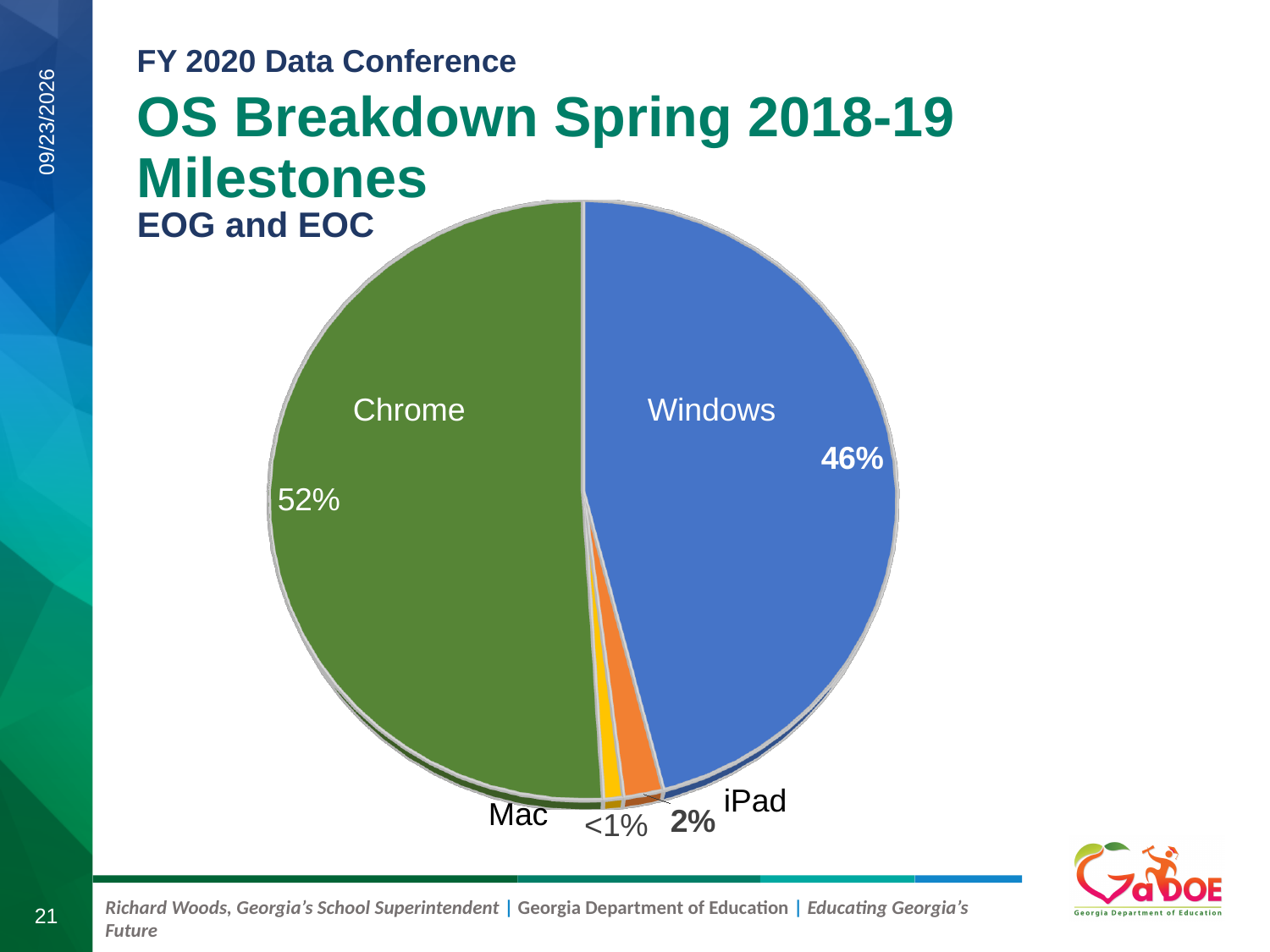
What share of the pie does Windows have? 46% What share of the pie does Mac have? <1% What is the title of the chart on the slide? OS Breakdown Spring 2018-19 Milestones Which slice is larger, Chrome or Windows? Chrome What kind of chart is shown on the slide? Pie chart What share of the pie does iPad have? 2% What share of the pie does Chrome have? 52% What is the difference in percentage points between the Chrome and Windows slices? 6 Which operating system has the largest slice of the pie? Chrome Which operating system has the smallest slice of the pie? Mac Which slice is larger, Windows or iPad? Windows How many slices does the pie chart have? 4